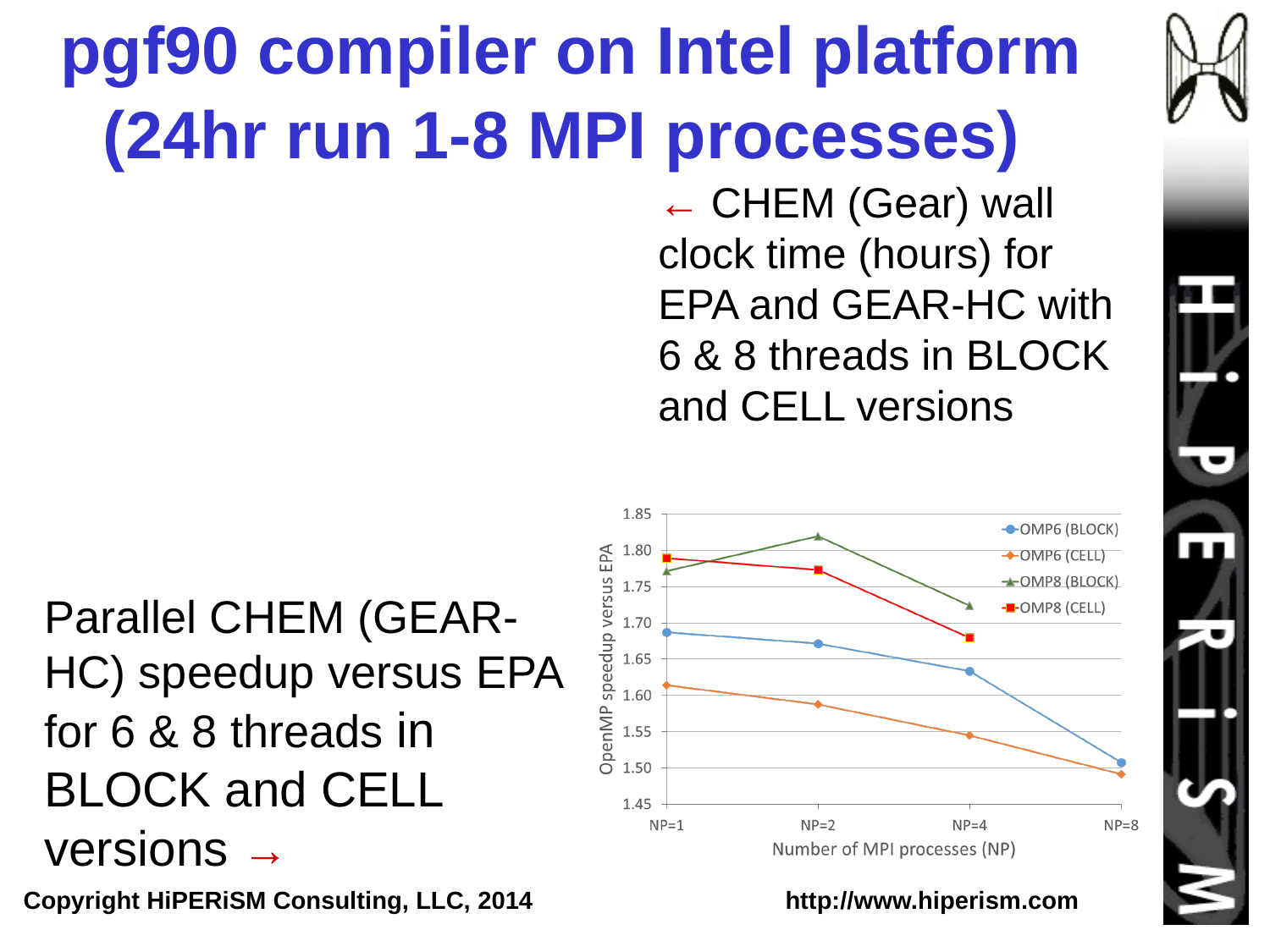
Is the value for OMP6 (BLOCK) at NP=8 greater or less than 1.55? less What kind of chart is shown on the slide? line chart Which series has the highest value at NP=2? OMP8 (BLOCK) Is the value for OMP8 (BLOCK) at NP=2 greater or less than 1.75? greater Is the value for OMP6 (CELL) at NP=1 greater or less than 1.65? less Does the OMP6 (CELL) series rise or fall as the number of MPI processes increases? fall At NP=1, which is larger: OMP8 (CELL) or OMP6 (CELL)? OMP8 (CELL) Which series has the lowest value at NP=4? OMP6 (CELL) What is the title of the chart's x axis? Number of MPI processes (NP) How many series does the chart's legend list? 4 How many NP categories are shown on the x axis of the chart? 4